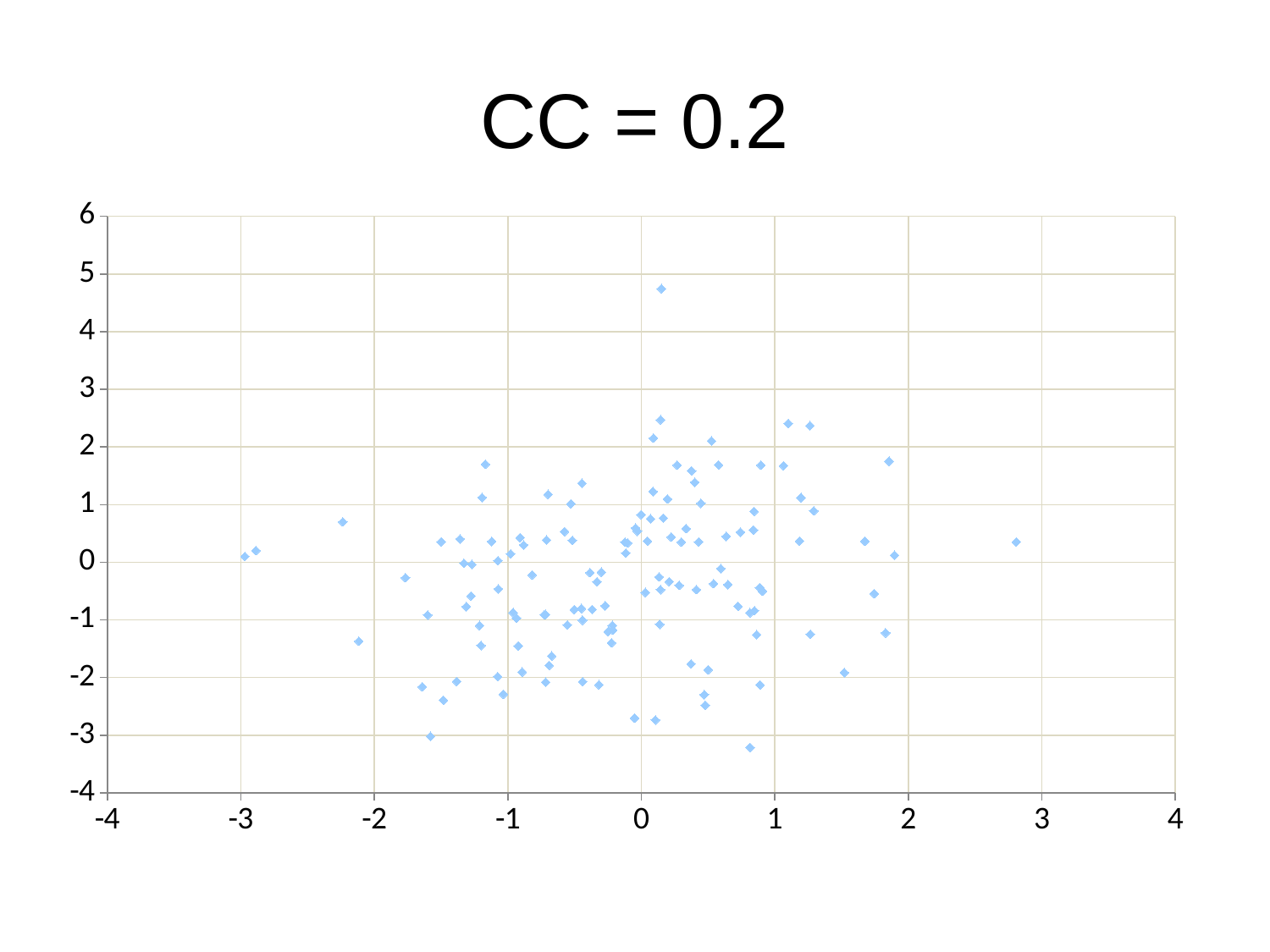
Is the x value of the leftmost point on the chart greater or less than -2? less What is the minimum value shown on the x axis? -4 What is the title of the chart? CC = 0.2 Is the y value of the lowest point on the chart greater or less than -3? less What is the maximum value shown on the y axis? 6 What kind of chart is shown on the slide? scatter chart